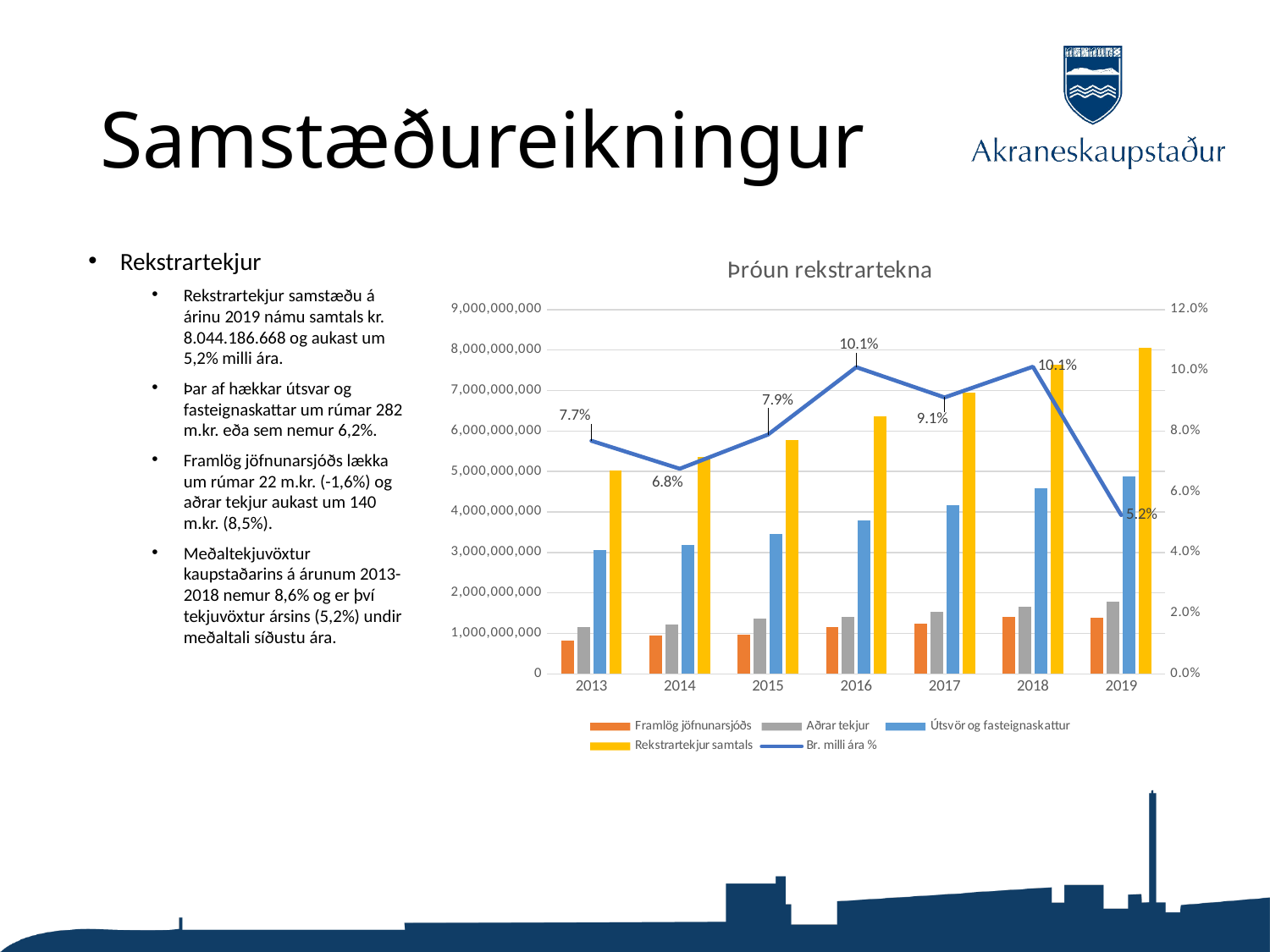
What is the value of Br. milli ára % for 2016? 10.1% Does Rekstrartekjur samtals rise or fall from 2013 to 2019? Rise Which year has the higher Br. milli ára %, 2013 or 2014? 2013 In which year is Br. milli ára % lowest? 2019 Is the value of Rekstrartekjur samtals for 2019 greater or less than 8,000,000,000? greater How many years are shown on the x axis of the chart? 7 What is the value of Br. milli ára % for 2014? 6.8% What kind of chart is shown on the slide? Combination bar and line chart Is the value of Framlög jöfnunarsjóðs for 2013 greater or less than 1,000,000,000? less What is the value of Br. milli ára % for 2019? 5.2% How many series does the legend list? 5 What is the difference between Br. milli ára % in 2018 and in 2019? 4.9%